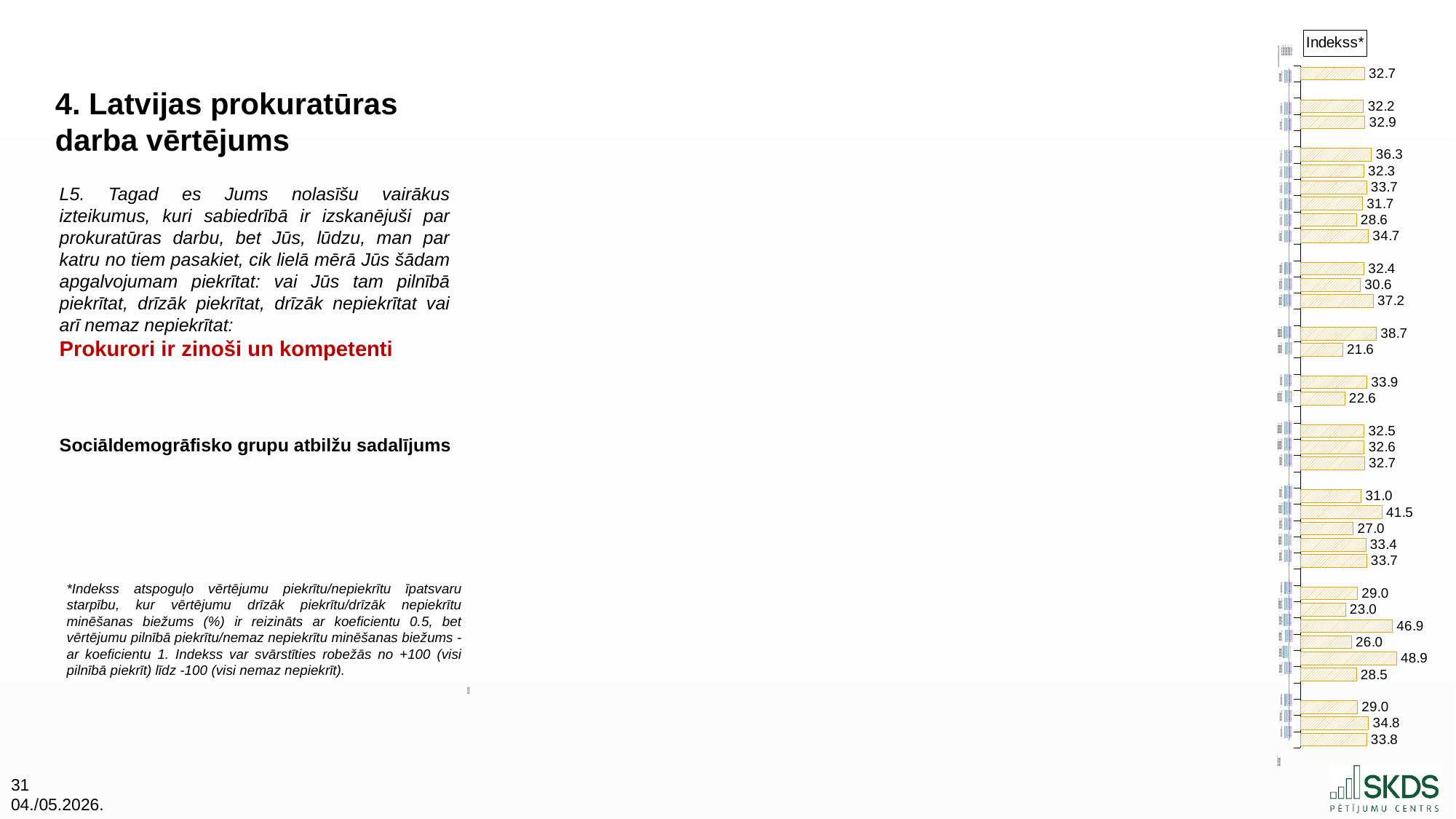
In the "Indekss*" chart, what is the value of the bottommost bar? 33.8 What is the title shown above the chart on the right of the slide? Indekss* In the "Indekss*" chart, what is the value of the topmost bar? 32.7 How many bars are plotted in the "Indekss*" chart? 33 In the "Indekss*" chart, which is larger: the topmost bar (32.7) or the bottommost bar (33.8)? the bottommost bar (33.8) In the "Indekss*" chart, what is the highest value shown by a data label? 48.9 In the "Indekss*" chart, what is the difference between the highest value (48.9) and the lowest value (21.6)? 27.3 In the "Indekss*" chart, what is the second-highest value shown by a data label? 46.9 In the "Indekss*" chart, what is the difference between the values 41.5 and 27.0 shown on adjacent bars? 14.5 In the "Indekss*" chart, what is the lowest value shown by a data label? 21.6 What kind of chart is the "Indekss*" chart on the right of the slide? bar chart In the "Indekss*" chart, which is larger: the bar labelled 38.7 or the bar labelled 21.6 directly below it? 38.7